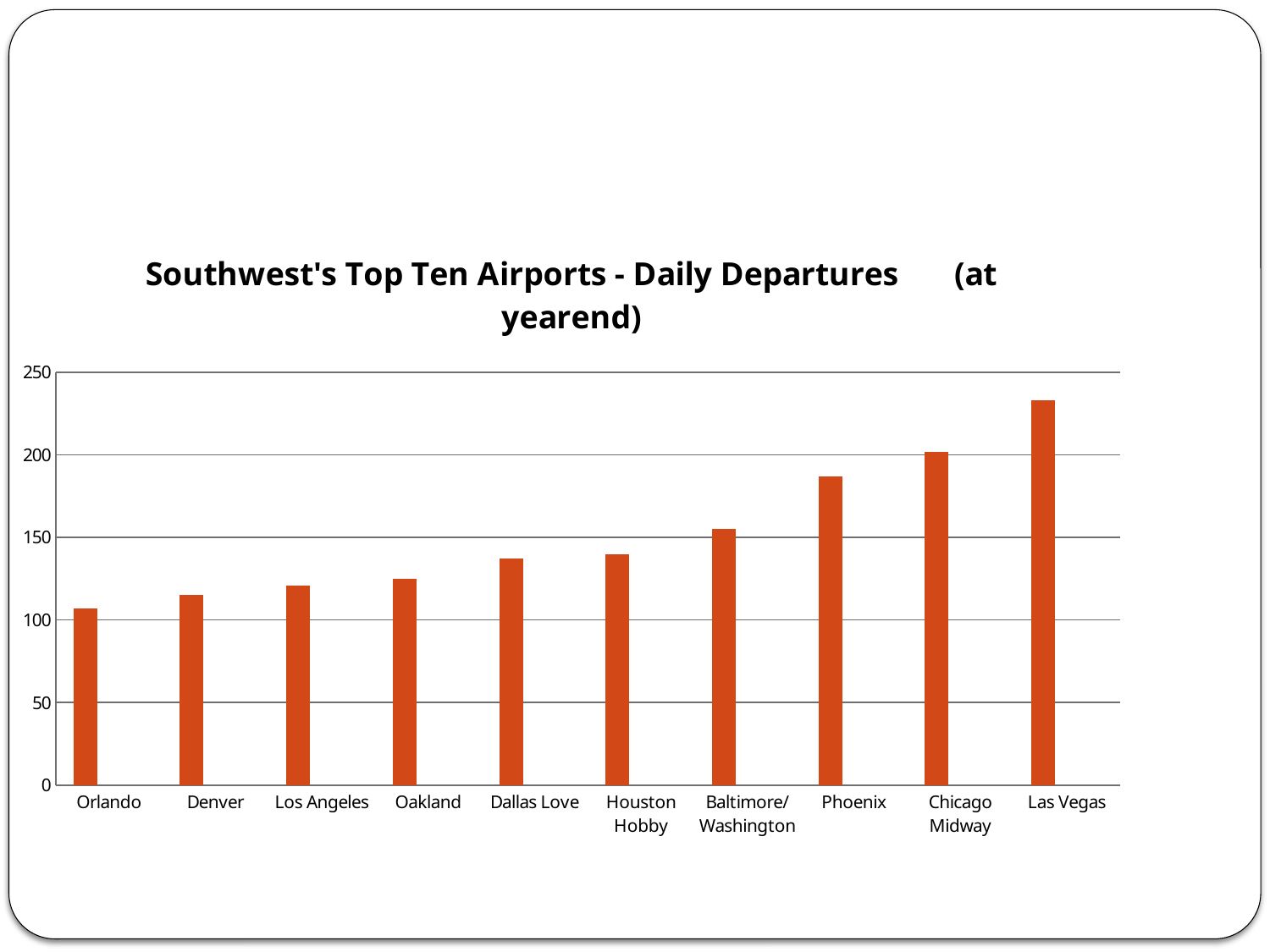
What kind of chart is shown on the slide? bar chart How many airports are shown on the chart? 10 Which has more daily departures, Phoenix or Baltimore/Washington? Phoenix Which airport has the lowest number of daily departures? Orlando Which has more daily departures, Orlando or Denver? Denver Is the value for Phoenix greater or less than 200? less Is the value for Oakland greater or less than 150? less Is the value for Las Vegas greater or less than 200? greater Do the values rise or fall from left to right along the x axis? rise Which airport has the highest number of daily departures? Las Vegas What is the title of the chart? Southwest's Top Ten Airports - Daily Departures (at yearend)